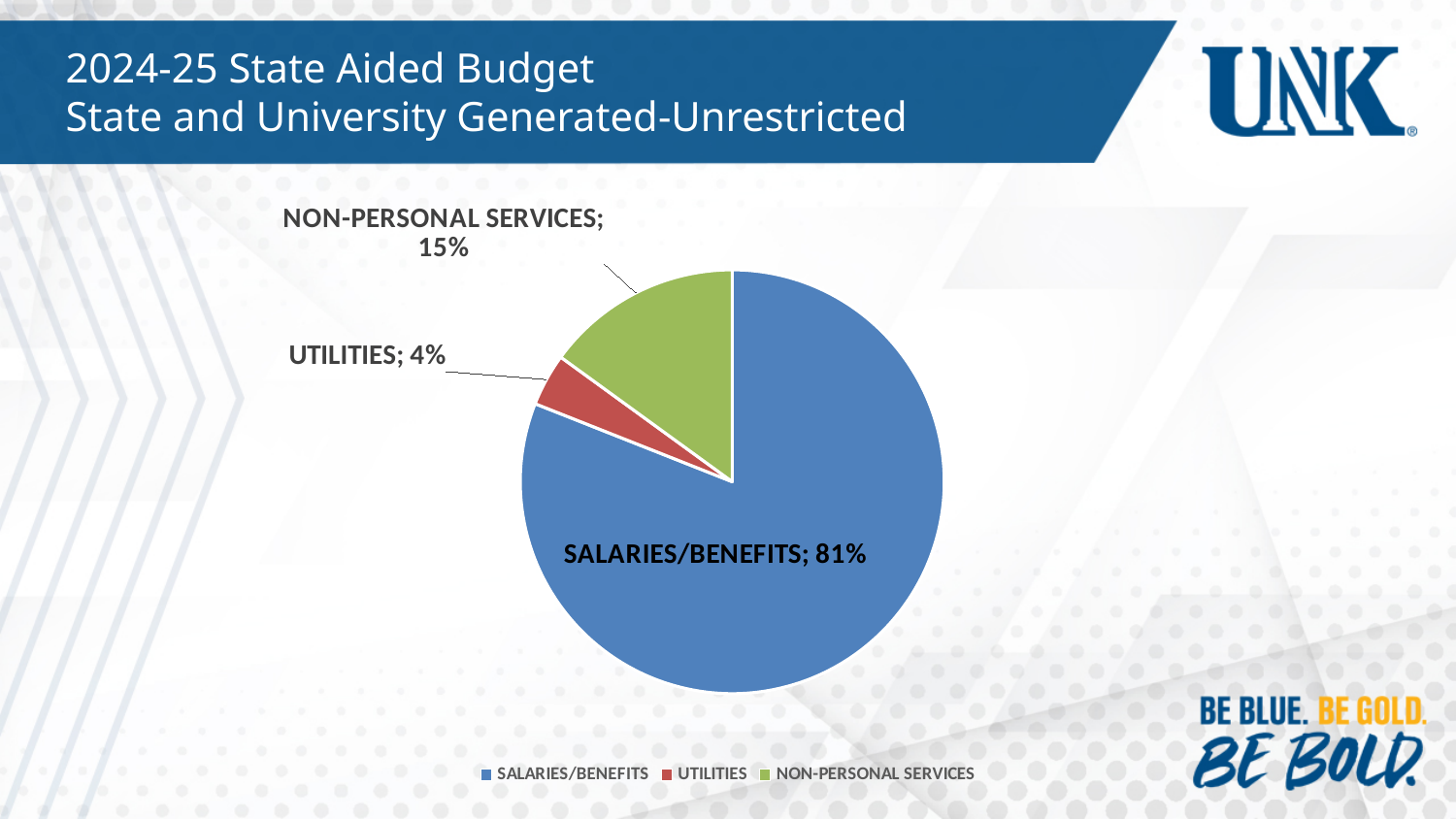
What share of the budget goes to SALARIES/BENEFITS? 81% Which category has the smallest slice of the pie? UTILITIES Which is larger, the share for UTILITIES or the share for NON-PERSONAL SERVICES? NON-PERSONAL SERVICES How many categories are shown in the pie chart? 3 What is the difference in percentage points between NON-PERSONAL SERVICES and UTILITIES? 11 What colour is the SALARIES/BENEFITS slice? blue What share of the budget goes to NON-PERSONAL SERVICES? 15% What is the difference in percentage points between SALARIES/BENEFITS and NON-PERSONAL SERVICES? 66 What kind of chart is shown on the slide? pie chart Which category has the largest slice of the pie? SALARIES/BENEFITS What share of the budget goes to UTILITIES? 4% How many entries does the legend list? 3